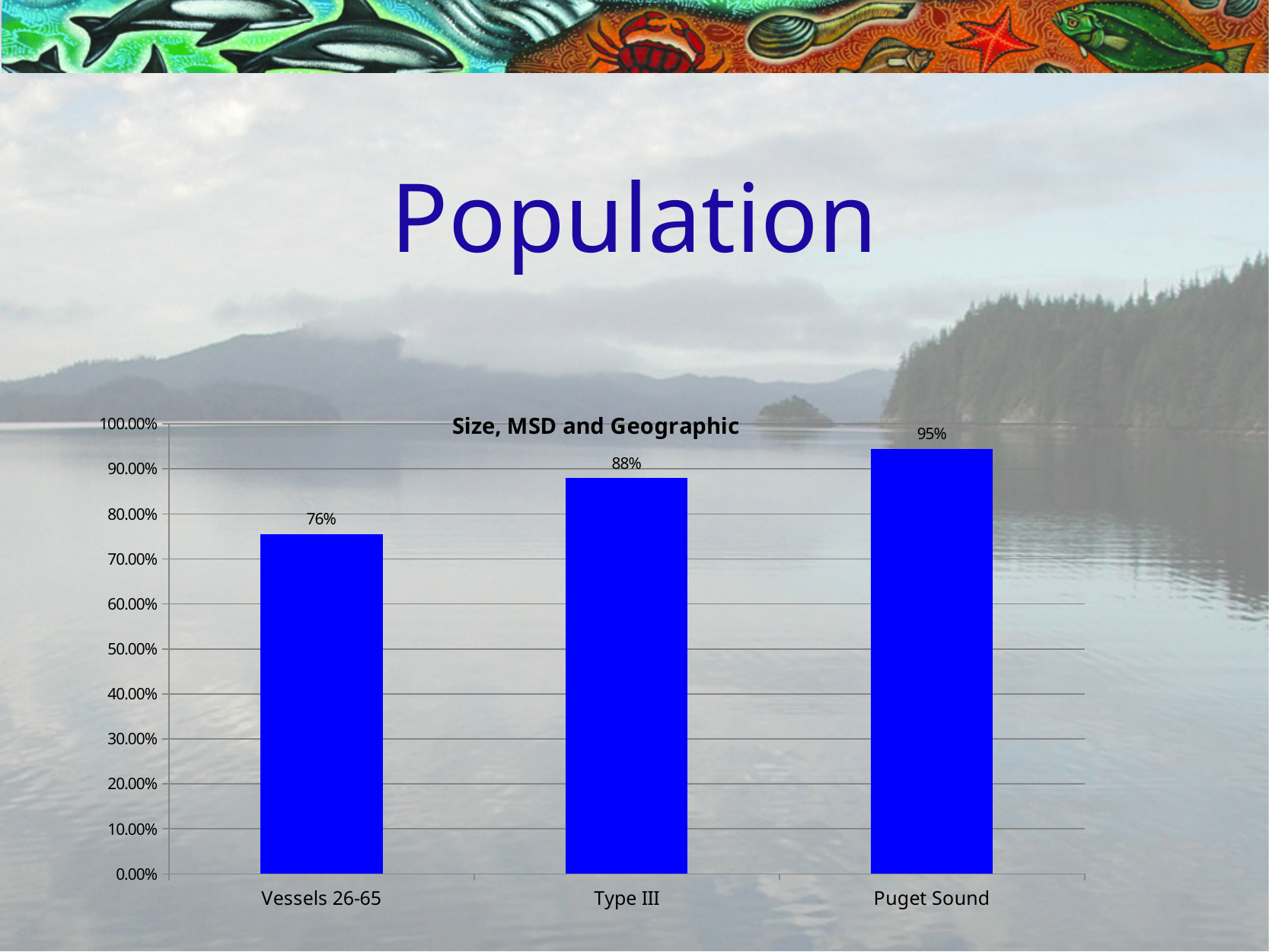
What is the value for Puget Sound? 95% Is the value for Vessels 26-65 greater or less than 80.00%? less How many categories are shown on the x axis? 3 Which category has the highest value? Puget Sound What is the value for Type III? 88% Which category has the lowest value? Vessels 26-65 Which is larger, the value for Type III or the value for Puget Sound? Puget Sound What is the difference between the values for Type III and Vessels 26-65? 12% What is the difference between the values for Puget Sound and Vessels 26-65? 19% What is the title of the chart? Size, MSD and Geographic What kind of chart is shown on the slide? bar chart What is the value for Vessels 26-65? 76%